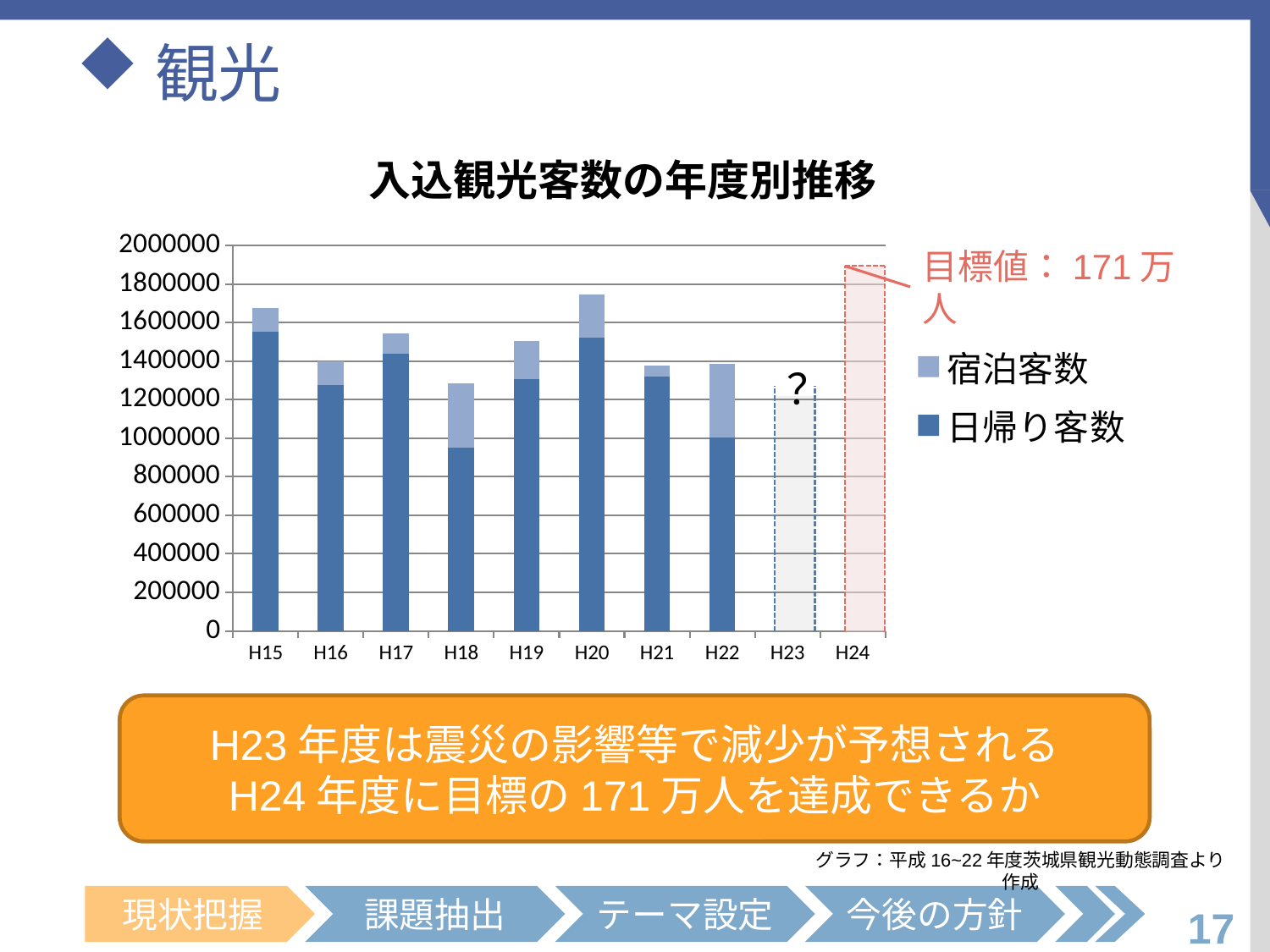
Is the total value for H20 greater or less than 1600000? greater Does the total number of visitors rise or fall from H15 to H16? fall What target value is annotated for H24 on the chart? 171万人 Which is larger, the total for H20 or the total for H21? H20 Is the total value for H18 greater or less than 1400000? less How many series does the legend list? 2 Which year has the highest total number of visitors among the plotted bars? H20 Which year from H15 to H22 has the lowest total number of visitors? H18 How many fiscal-year categories are shown on the x axis? 10 Is the 日帰り客数 value for H20 greater or less than 1400000? greater What kind of chart is shown on the slide? Stacked bar chart What are the two series named in the legend? 宿泊客数 and 日帰り客数